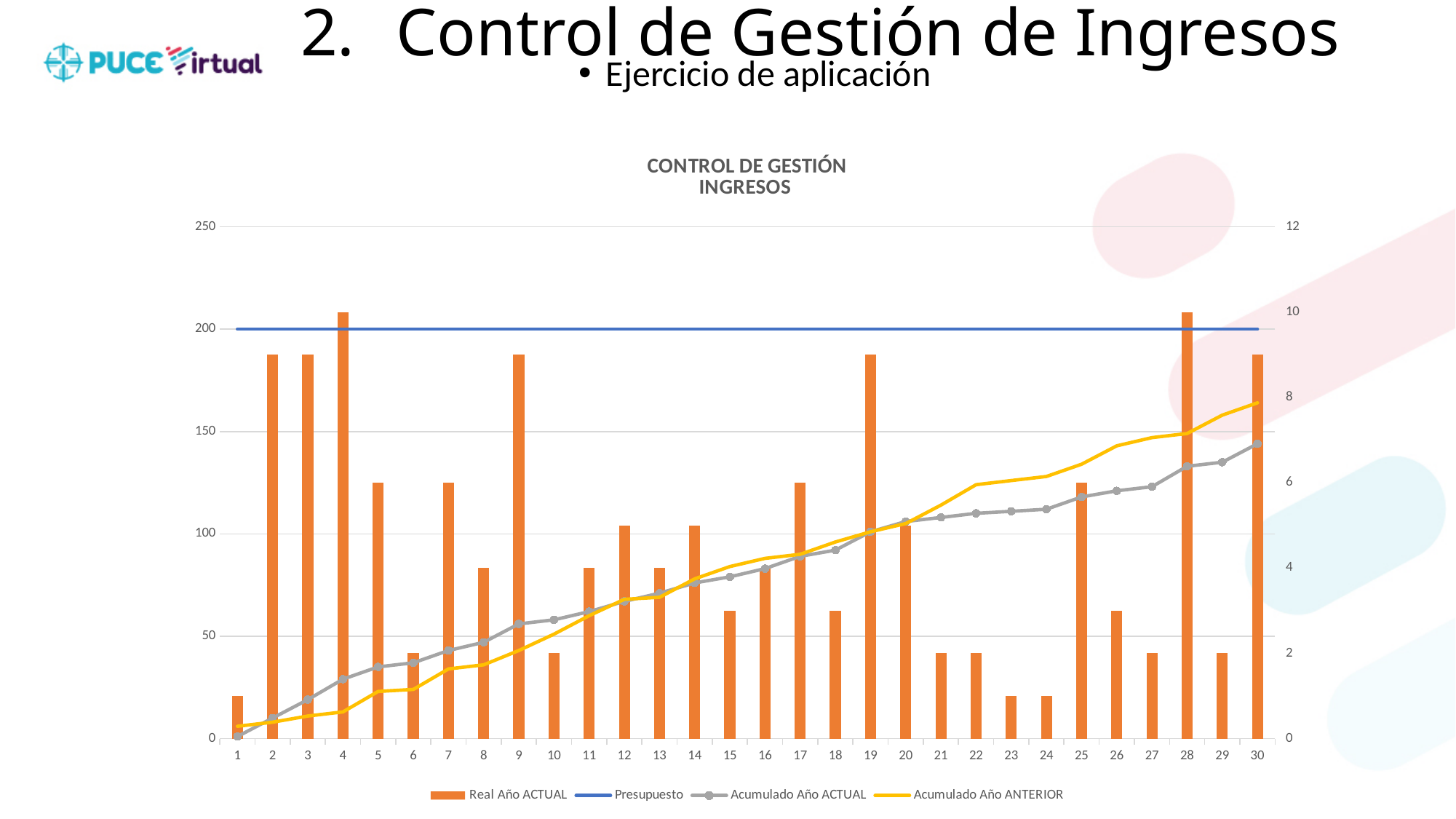
Which has the larger Real Año ACTUAL value, category 4 or category 5? Category 4 What is the value of the Presupuesto line? 200 How many categories are shown along the x axis? 30 Is the Real Año ACTUAL value for category 23 greater or less than 50? less Is the Real Año ACTUAL value for category 10 greater or less than 50? less Does the Acumulado Año ACTUAL line rise or fall from category 1 to category 30? It rises What is the title of the chart? CONTROL DE GESTIÓN INGRESOS How many series does the legend list? 4 Which has the larger Real Año ACTUAL value, category 2 or category 10? Category 2 What kind of chart is shown on the slide? A combined bar and line chart